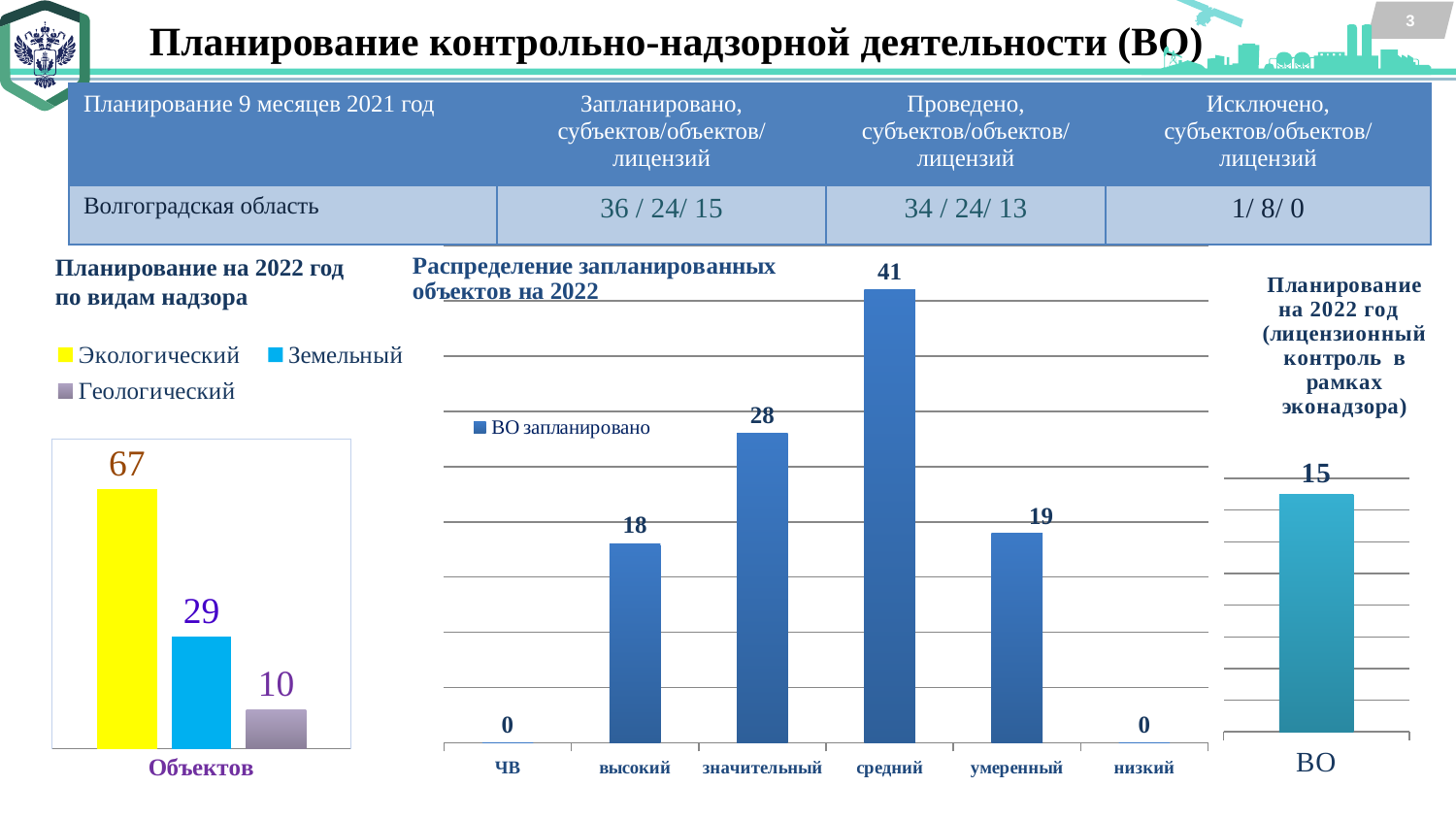
In the middle chart 'Распределение запланированных объектов на 2022', what is the difference between средний and значительный? 13 In the left chart 'Планирование на 2022 год по видам надзора', how many series does the legend list? 3 In the middle chart 'Распределение запланированных объектов на 2022', what is the value for высокий? 18 In the middle chart 'Распределение запланированных объектов на 2022', which category has the highest value? средний In the right chart 'Планирование на 2022 год (лицензионный контроль в рамках эконадзора)', what is the value for ВО? 15 In the left chart 'Планирование на 2022 год по видам надзора', which category has the lowest value? Геологический In the left chart 'Планирование на 2022 год по видам надзора', what is the value for Экологический? 67 In the middle chart 'Распределение запланированных объектов на 2022', what is the value for средний? 41 What kind of chart is the middle chart 'Распределение запланированных объектов на 2022'? bar chart In the middle chart 'Распределение запланированных объектов на 2022', which is larger: значительный or умеренный? значительный In the middle chart 'Распределение запланированных объектов на 2022', how many categories are shown on the x axis? 6 In the left chart 'Планирование на 2022 год по видам надзора', what is the difference between Экологический and Земельный? 38